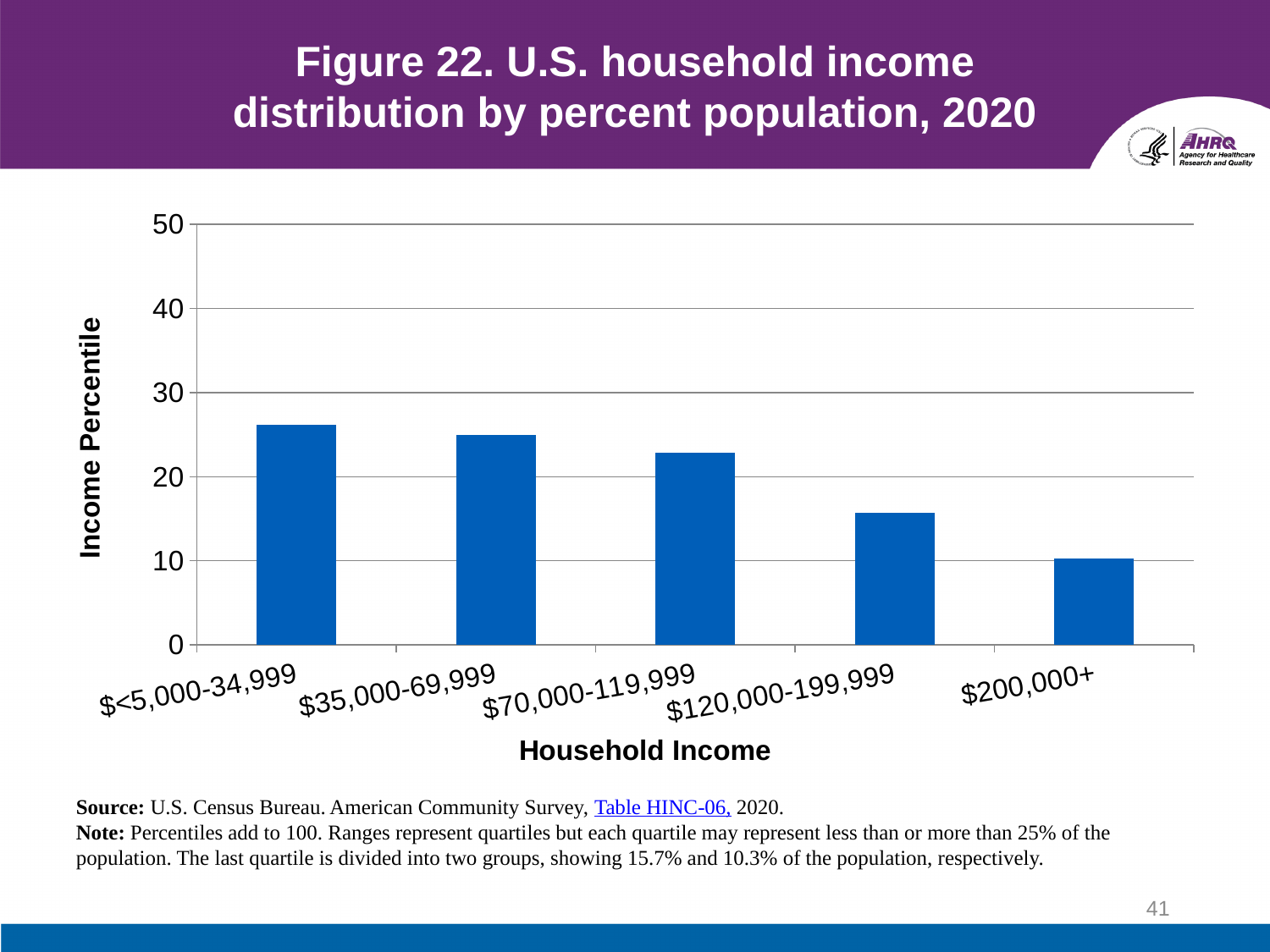
Which household income category has the lowest income percentile? $200,000+ Is the value for $<5,000-34,999 greater or less than 20? greater Is the value for $70,000-119,999 greater or less than 20? greater Is the value for $35,000-69,999 greater or less than 30? less Which is larger, the value for $70,000-119,999 or the value for $120,000-199,999? $70,000-119,999 Which household income category has the highest income percentile? $<5,000-34,999 What is the title of the y axis? Income Percentile According to the note on the slide, what percent of the population does the $200,000+ group represent? 10.3% Do the values rise or fall moving from left to right along the x axis? fall How many household income categories are shown on the x axis? 5 What kind of chart is shown on the slide? bar chart